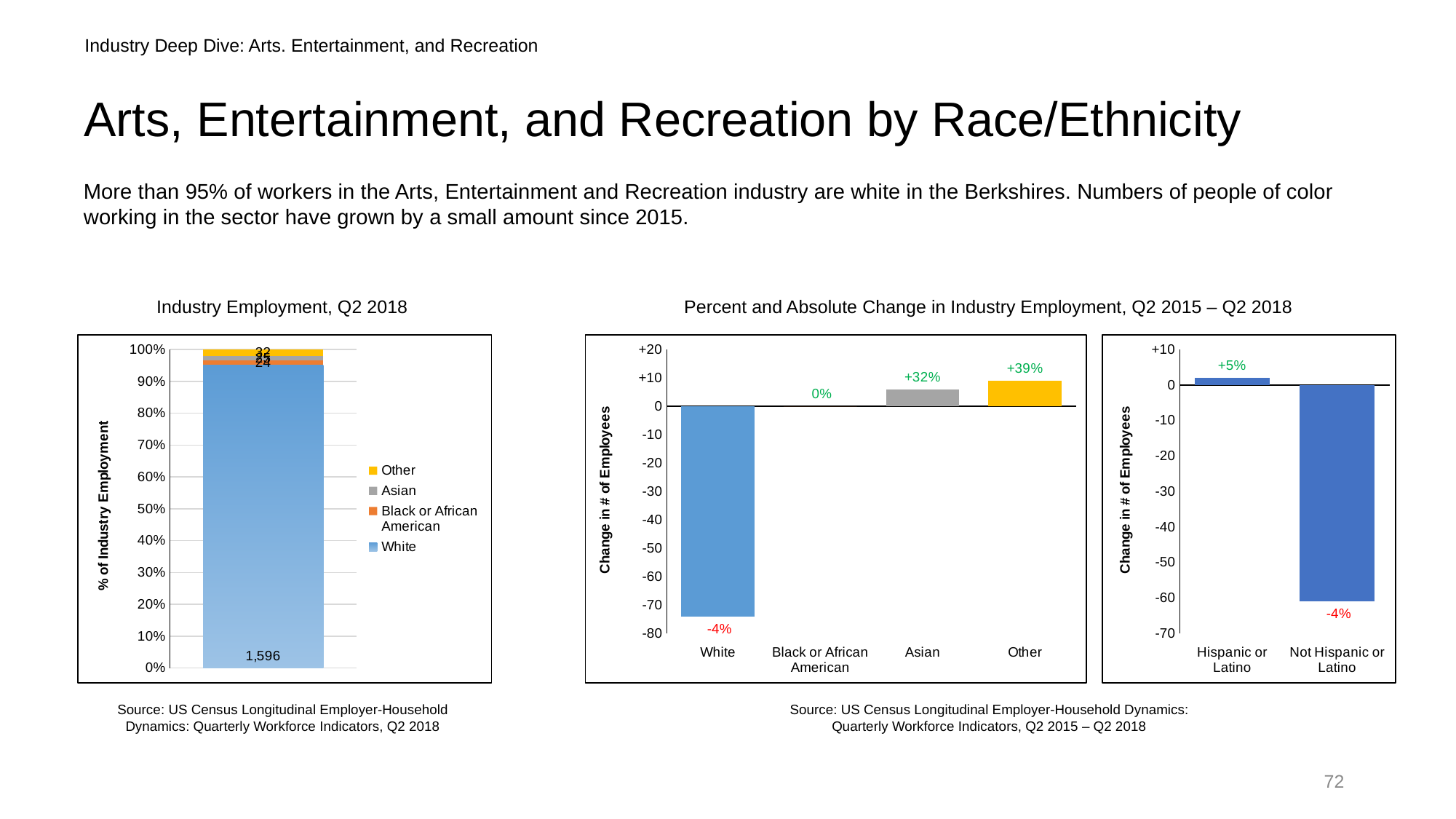
In the middle chart (Percent and Absolute Change in Industry Employment by race), which category has the lowest change in number of employees? White In the middle chart (Percent and Absolute Change in Industry Employment by race), what is the percent change shown for Black or African American? 0% In the right chart (Percent and Absolute Change in Industry Employment by Hispanic/Latino status), is the change in number of employees for Not Hispanic or Latino greater or less than -50? less In the middle chart (Percent and Absolute Change in Industry Employment by race), what is the percent change shown for Other? +39% In the middle chart (Percent and Absolute Change in Industry Employment by race), how many categories are shown on the x axis? 4 In the 'Industry Employment, Q2 2018' chart, how many series does the legend list? 4 In the right chart (Percent and Absolute Change in Industry Employment by Hispanic/Latino status), what is the percent change shown for Hispanic or Latino? +5% In the middle chart (Percent and Absolute Change in Industry Employment by race), is the change in number of employees for White greater or less than -70? less In the middle chart (Percent and Absolute Change in Industry Employment by race), which category has the largest change in number of employees? Other What kind of chart is the 'Industry Employment, Q2 2018' chart on the left? Stacked bar chart In the 'Industry Employment, Q2 2018' chart, what is the data label shown on the White segment? 1,596 In the middle chart (Percent and Absolute Change in Industry Employment by race), what is the percent change shown for Asian? +32%